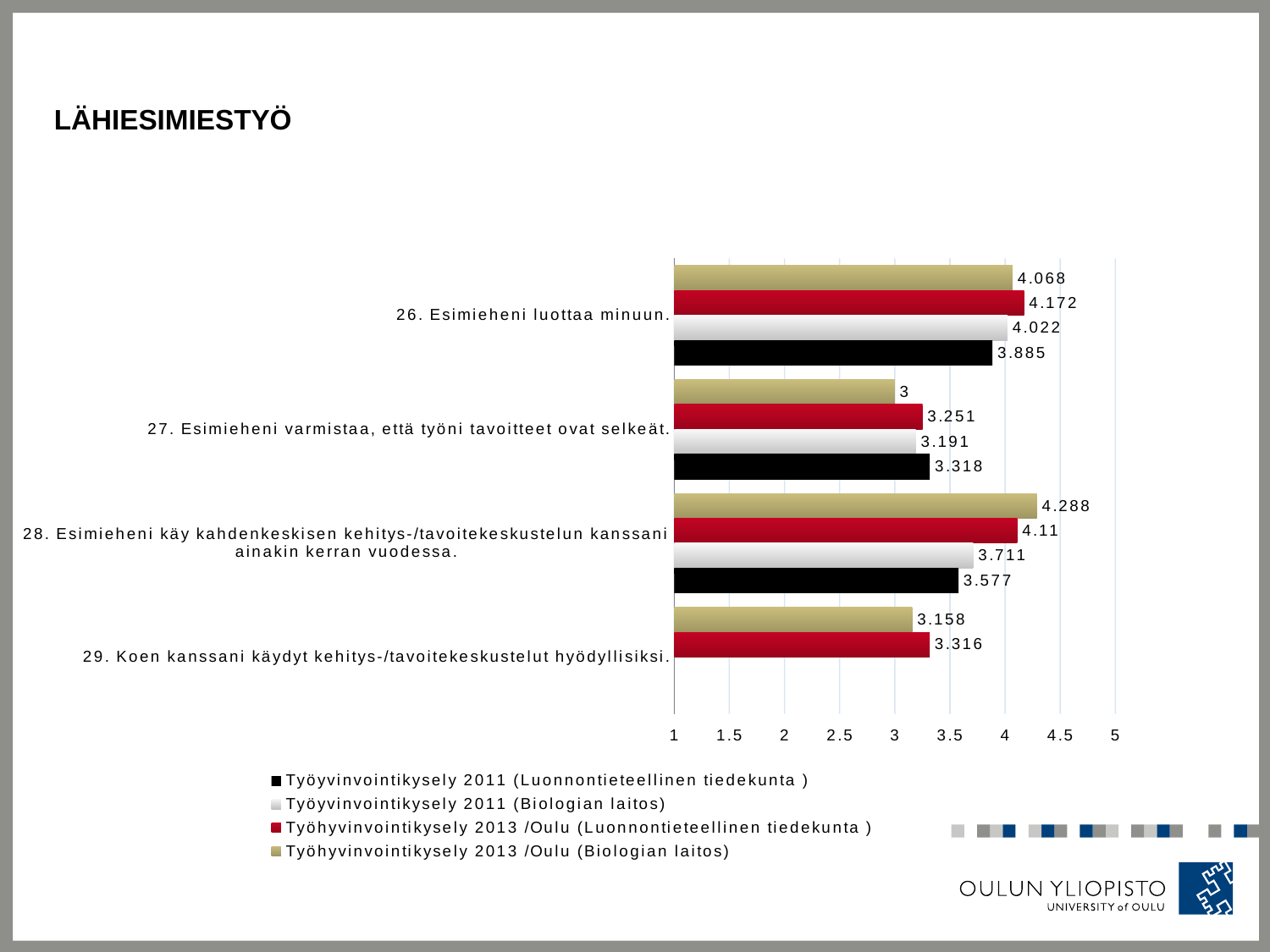
Is the value for '29. Koen kanssani käydyt kehitys-/tavoitekeskustelut hyödyllisiksi.' in the Työhyvinvointikysely 2013 /Oulu (Biologian laitos) series greater or less than 3.5? less For '26. Esimieheni luottaa minuun.', which is larger: the Työyvinvointikysely 2011 (Biologian laitos) value or the Työyvinvointikysely 2011 (Luonnontieteellinen tiedekunta) value? Työyvinvointikysely 2011 (Biologian laitos) What is the value for '26. Esimieheni luottaa minuun.' in the Työhyvinvointikysely 2013 /Oulu (Luonnontieteellinen tiedekunta) series? 4.172 What kind of chart is shown on the slide? bar chart What is the value for '28. Esimieheni käy kahdenkeskisen kehitys-/tavoitekeskustelun kanssani ainakin kerran vuodessa.' in the Työyvinvointikysely 2011 (Luonnontieteellinen tiedekunta) series? 3.577 What is the value for '29. Koen kanssani käydyt kehitys-/tavoitekeskustelut hyödyllisiksi.' in the Työhyvinvointikysely 2013 /Oulu (Luonnontieteellinen tiedekunta) series? 3.316 What is the value for '27. Esimieheni varmistaa, että työni tavoitteet ovat selkeät.' in the Työhyvinvointikysely 2013 /Oulu (Biologian laitos) series? 3 Which category has the highest value in the Työhyvinvointikysely 2013 /Oulu (Biologian laitos) series? 28. Esimieheni käy kahdenkeskisen kehitys-/tavoitekeskustelun kanssani ainakin kerran vuodessa. How many series does the legend list? 4 How many categories are shown on the chart? 4 What is the difference between the Työhyvinvointikysely 2013 /Oulu (Biologian laitos) and Työyvinvointikysely 2011 (Biologian laitos) values for '28. Esimieheni käy kahdenkeskisen kehitys-/tavoitekeskustelun kanssani ainakin kerran vuodessa.'? 0.577 Which category has the lowest value in the Työyvinvointikysely 2011 (Biologian laitos) series? 27. Esimieheni varmistaa, että työni tavoitteet ovat selkeät.